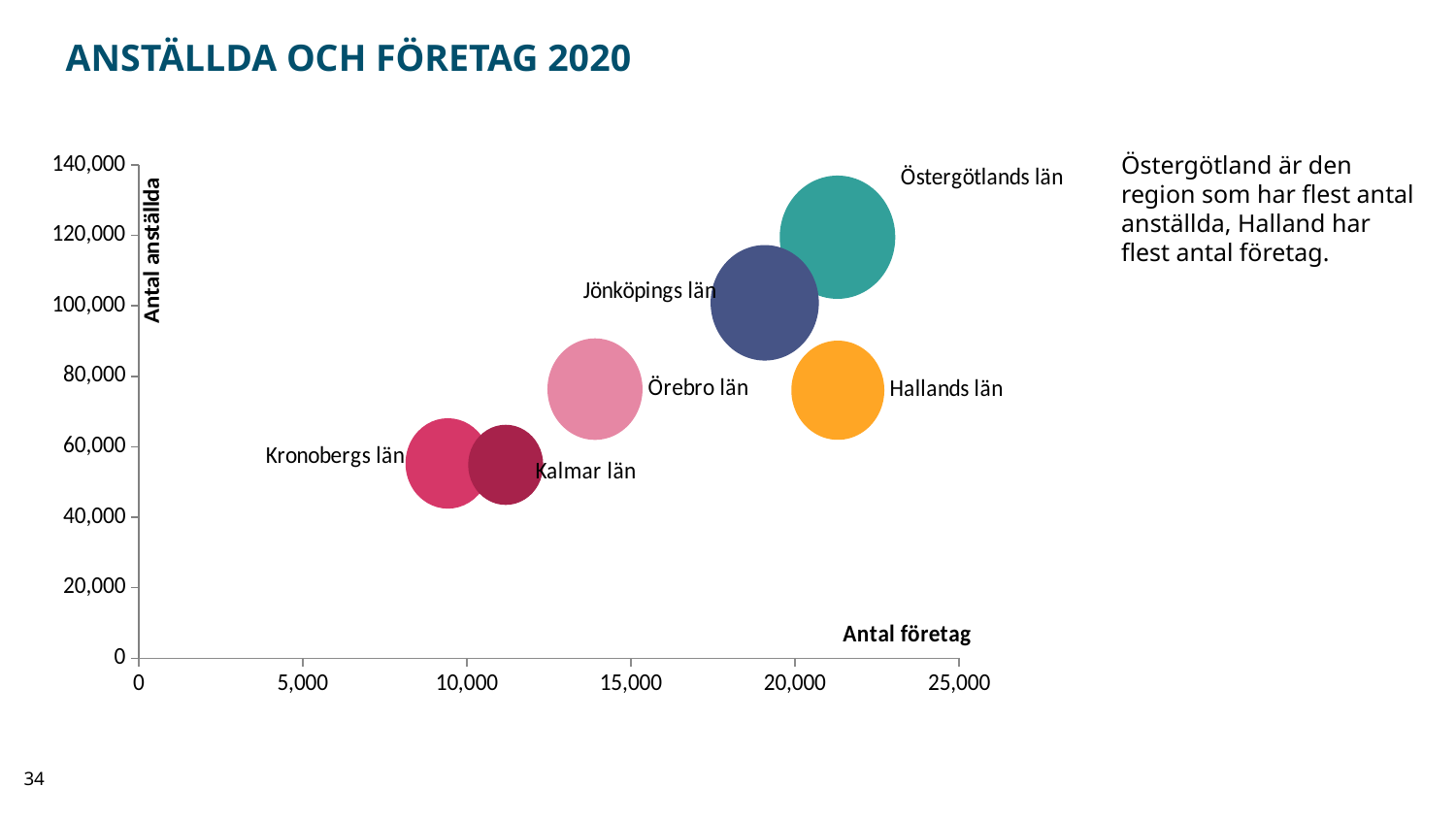
Is the number of employees for Hallands län greater or less than 100,000? less Is the number of companies for Jönköpings län greater or less than 15,000? greater Is the number of employees for Kronobergs län greater or less than 80,000? less Which region has more companies, Jönköpings län or Örebro län? Jönköpings län Which region has the lowest number of companies (Antal företag)? Kronobergs län What is the title of the chart on the slide? ANSTÄLLDA OCH FÖRETAG 2020 How many regions (bubbles) are plotted in the chart? 6 Which region has the highest number of employees (Antal anställda)? Östergötlands län What kind of chart is shown on the slide? Bubble chart Which region has more employees, Östergötlands län or Hallands län? Östergötlands län